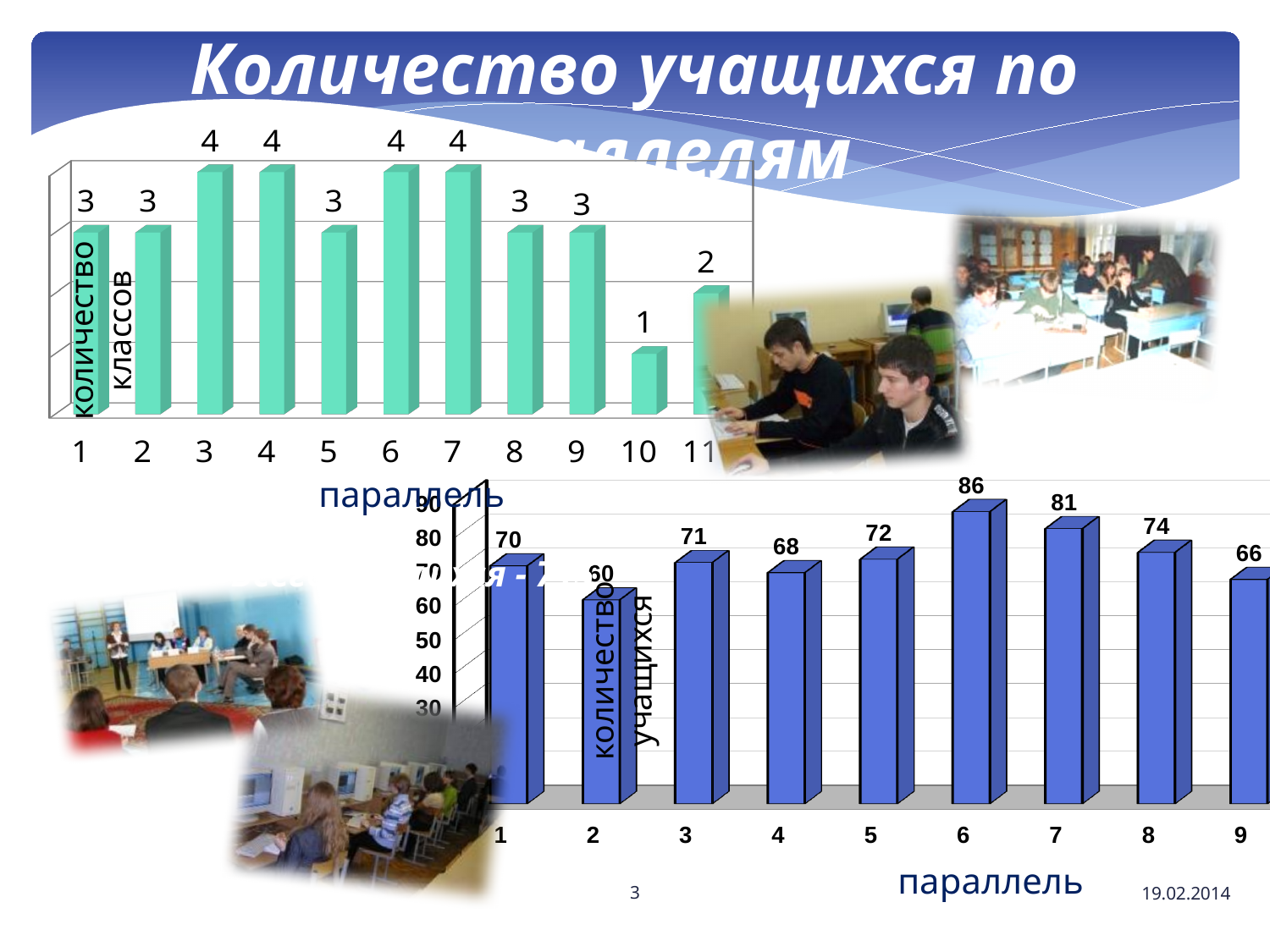
In the bottom chart, what is the difference in the number of students between parallel 6 and parallel 7? 5 In the top chart, how many parallels are shown on the x axis? 11 In the bottom chart, how many students are in parallel 2? 60 In the top chart, how many classes are there in parallel 3? 4 What type of chart is the bottom chart? bar chart In the top chart, how many classes are there in parallel 10? 1 In the bottom chart, which has more students, parallel 4 or parallel 5? parallel 5 In the top chart, what is the difference between the number of classes in parallel 7 and parallel 11? 2 What is the label of the x axis on the bottom chart? параллель In the top chart, which parallel has the lowest number of classes? 10 In the bottom chart, which parallel has the highest number of students? 6 In the bottom chart, how many students are in parallel 6? 86